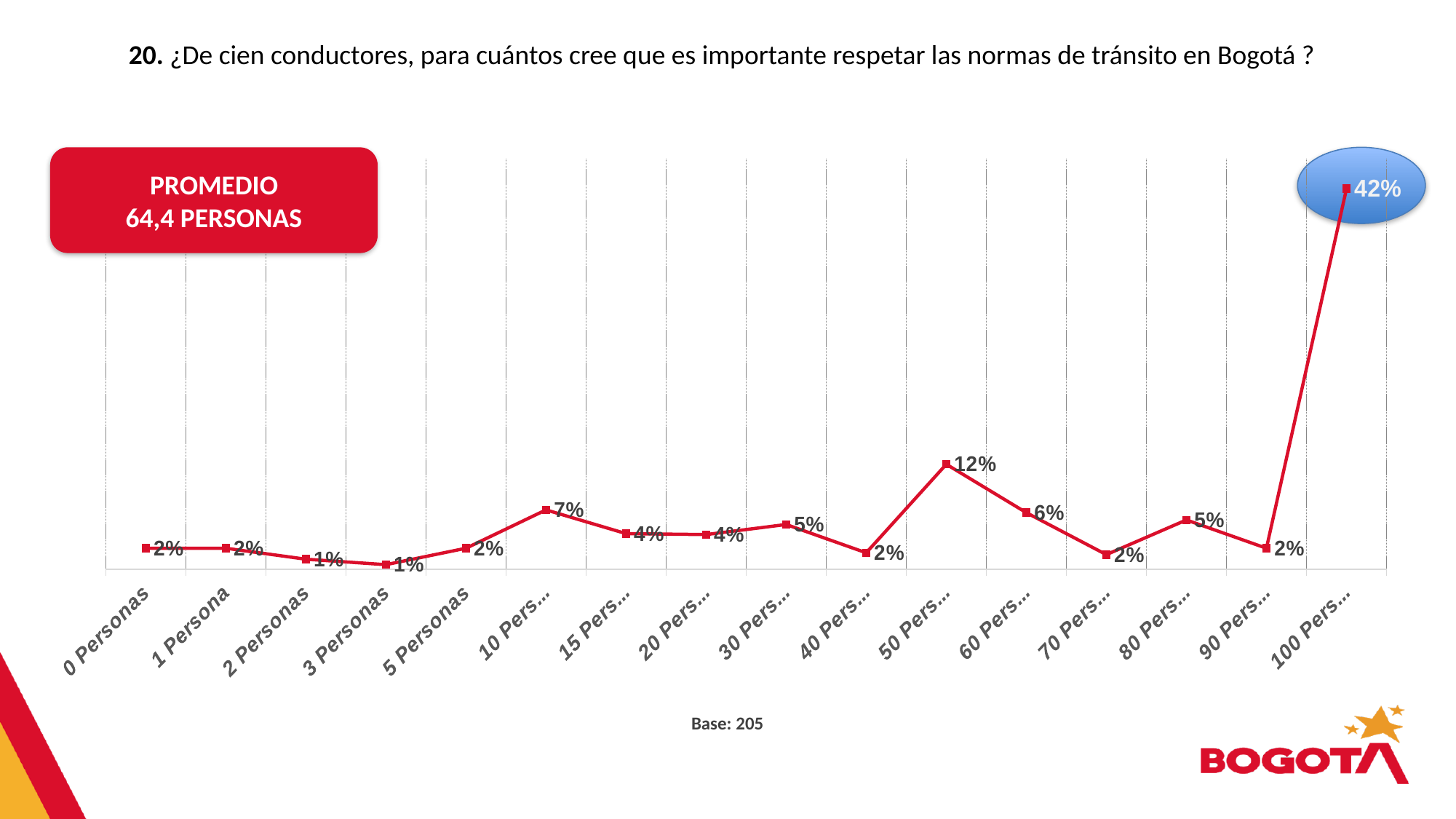
What is the difference between the values for 100 Personas and 50 Personas? 30 percentage points What average (promedio) is shown in the red box on the slide? 64,4 personas What is the value for 10 Personas? 7% Which category has the highest value? 100 Personas Which is larger, the value for 50 Personas or the value for 60 Personas? 50 Personas How many categories are plotted on the x axis? 16 What base (sample size) is stated below the chart? 205 What is the value for 50 Personas? 12% What is the value for 2 Personas? 1% What kind of chart is shown on the slide? line chart What is the value for 100 Personas? 42% What is the lowest value plotted on the chart? 1%